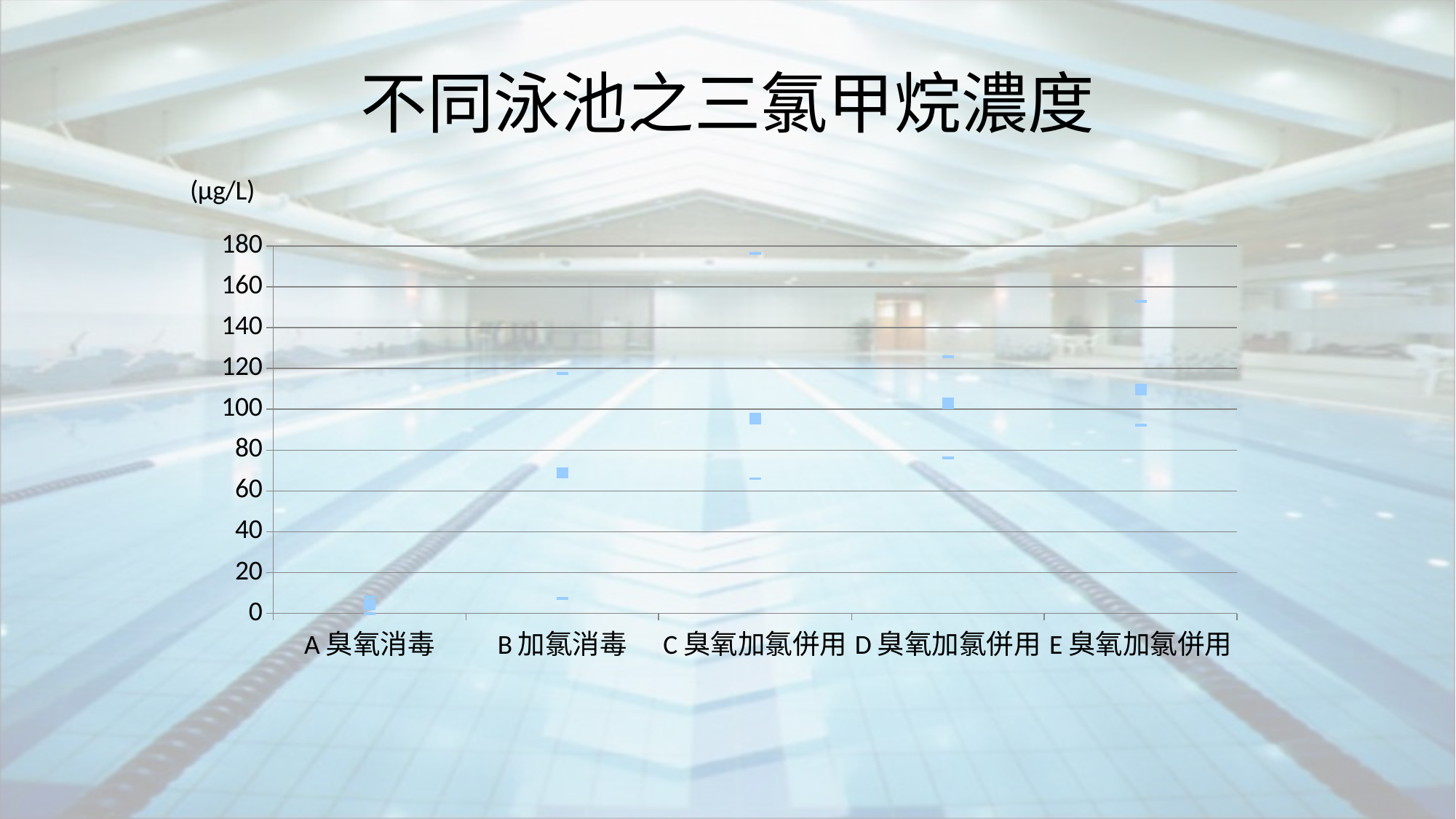
What unit is shown for the y axis of the chart? µg/L How many swimming pool categories are shown on the x axis of the chart? 5 Which category has the highest upper dash marker on the chart? C 臭氧加氯併用 What is the title of the chart? 不同泳池之三氯甲烷濃度 Is the square marker for A 臭氧消毒 greater or less than 20? less Is the square marker for B 加氯消毒 greater or less than 60? greater Which category has the lowest square marker on the chart? A 臭氧消毒 Is the topmost dash marker for C 臭氧加氯併用 greater or less than 160? greater Which has the larger square marker value, B 加氯消毒 or C 臭氧加氯併用? C 臭氧加氯併用